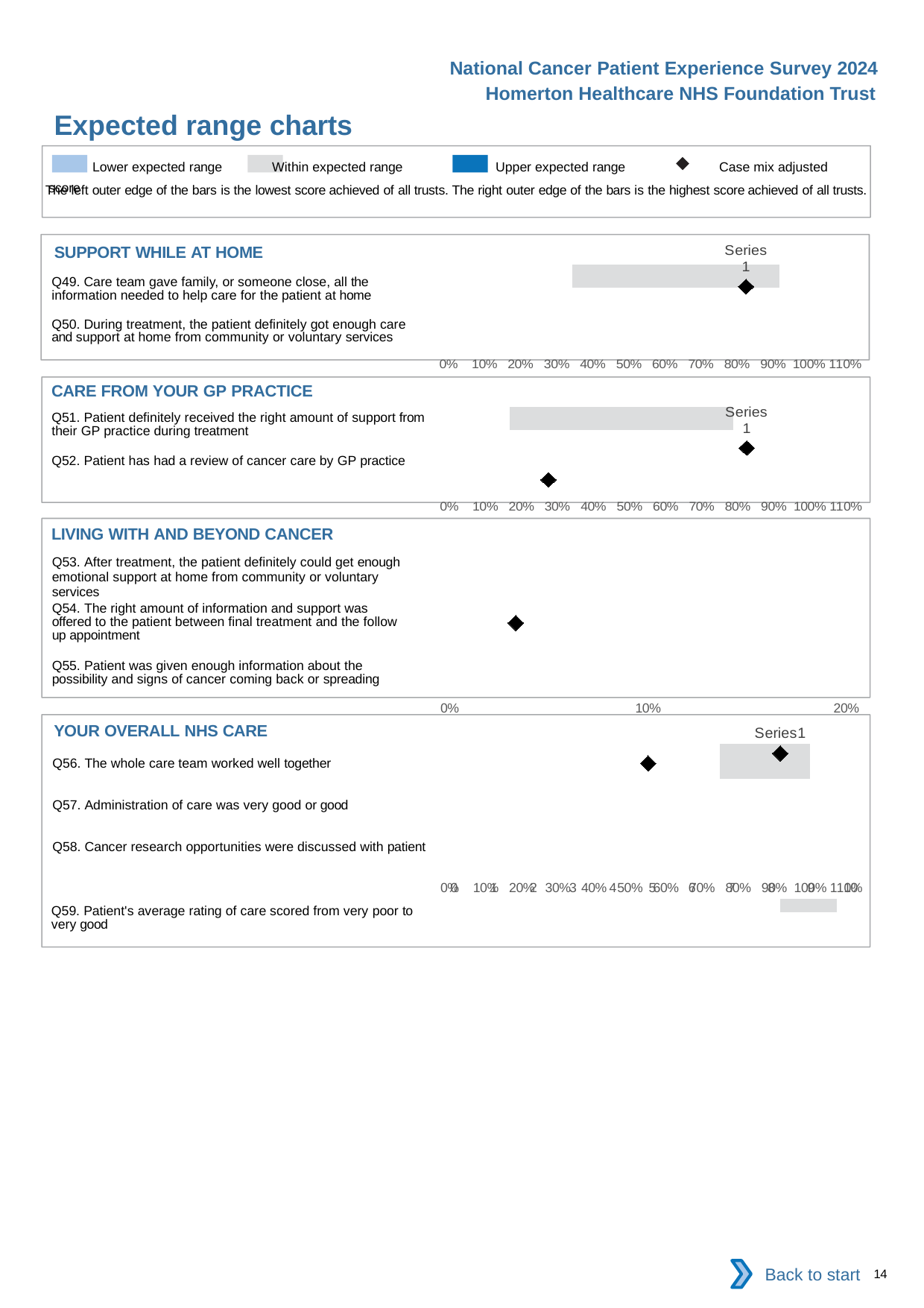
How many questions are listed in the YOUR OVERALL NHS CARE chart? 4 In the YOUR OVERALL NHS CARE chart, is the case mix adjusted score for Q56 greater or less than 40%? greater How many questions are listed in the LIVING WITH AND BEYOND CANCER chart? 3 What symbol does the legend use for the case mix adjusted score? A black diamond In the CARE FROM YOUR GP PRACTICE chart, which question has the higher case mix adjusted score, Q51 or Q52? Q51 In the CARE FROM YOUR GP PRACTICE chart, is the case mix adjusted score for Q52 greater or less than 40%? less In the SUPPORT WHILE AT HOME chart, is the case mix adjusted score for Q49 greater or less than 70%? greater How many entries does the legend at the top of the slide list? 4 In the CARE FROM YOUR GP PRACTICE chart, which question has the lowest case mix adjusted score? Q52 What is the title of the slide containing these charts? Expected range charts